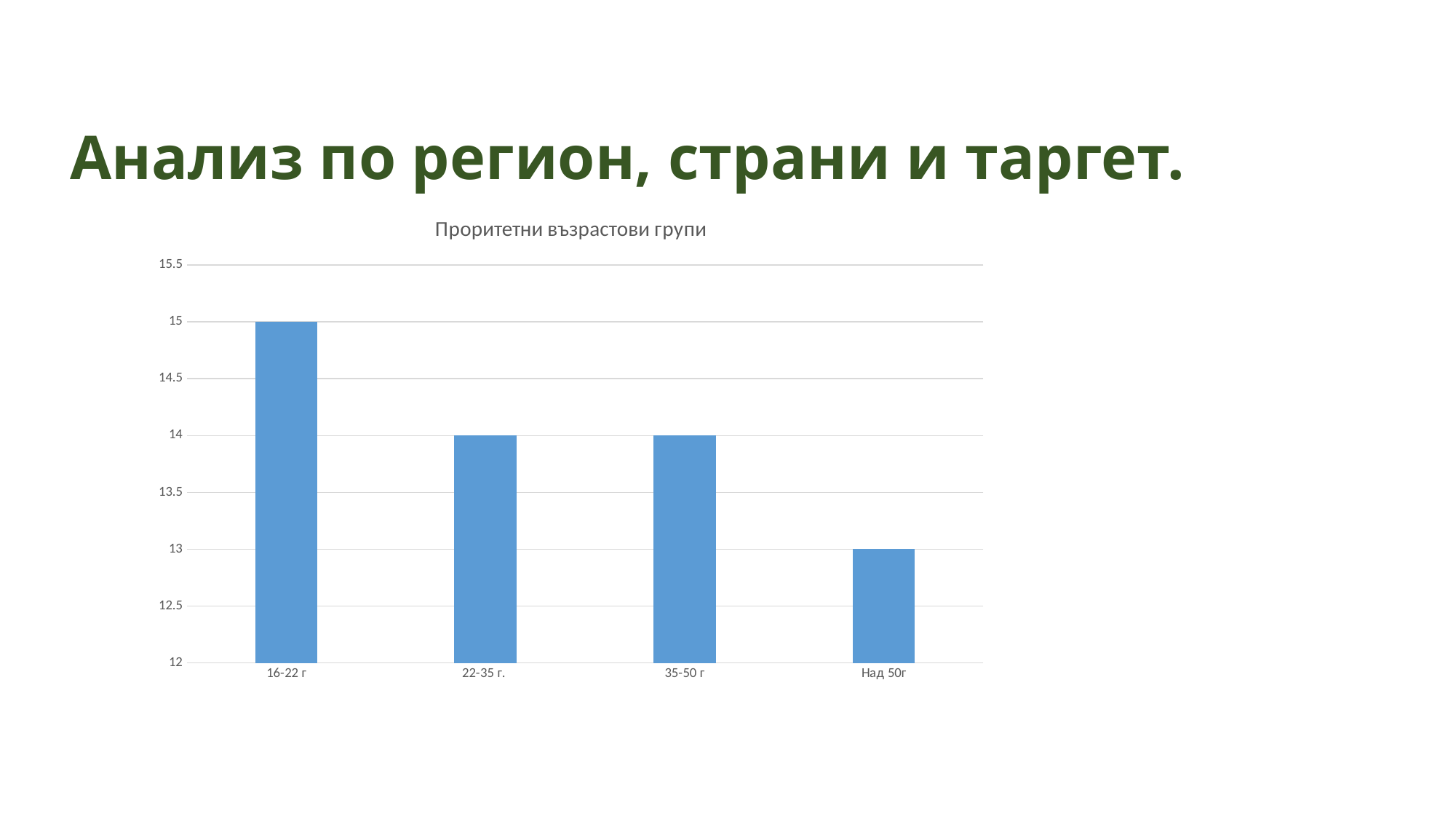
Which category has the highest value? 16-22 г What is the value for the 22-35 г. category? 14 What is the title of the chart? Проритетни възрастови групи What is the difference between the values for 16-22 г and Над 50г? 2 Do the values rise or fall from left to right along the x axis? fall Which category has the lowest value? Над 50г What is the value for the Над 50г category? 13 How many categories are shown on the x axis? 4 What is the value for the 16-22 г category? 15 Is the value for 22-35 г. greater or less than 13.5? greater What kind of chart is shown on the slide? bar chart Which is larger, the value for 35-50 г or the value for Над 50г? 35-50 г